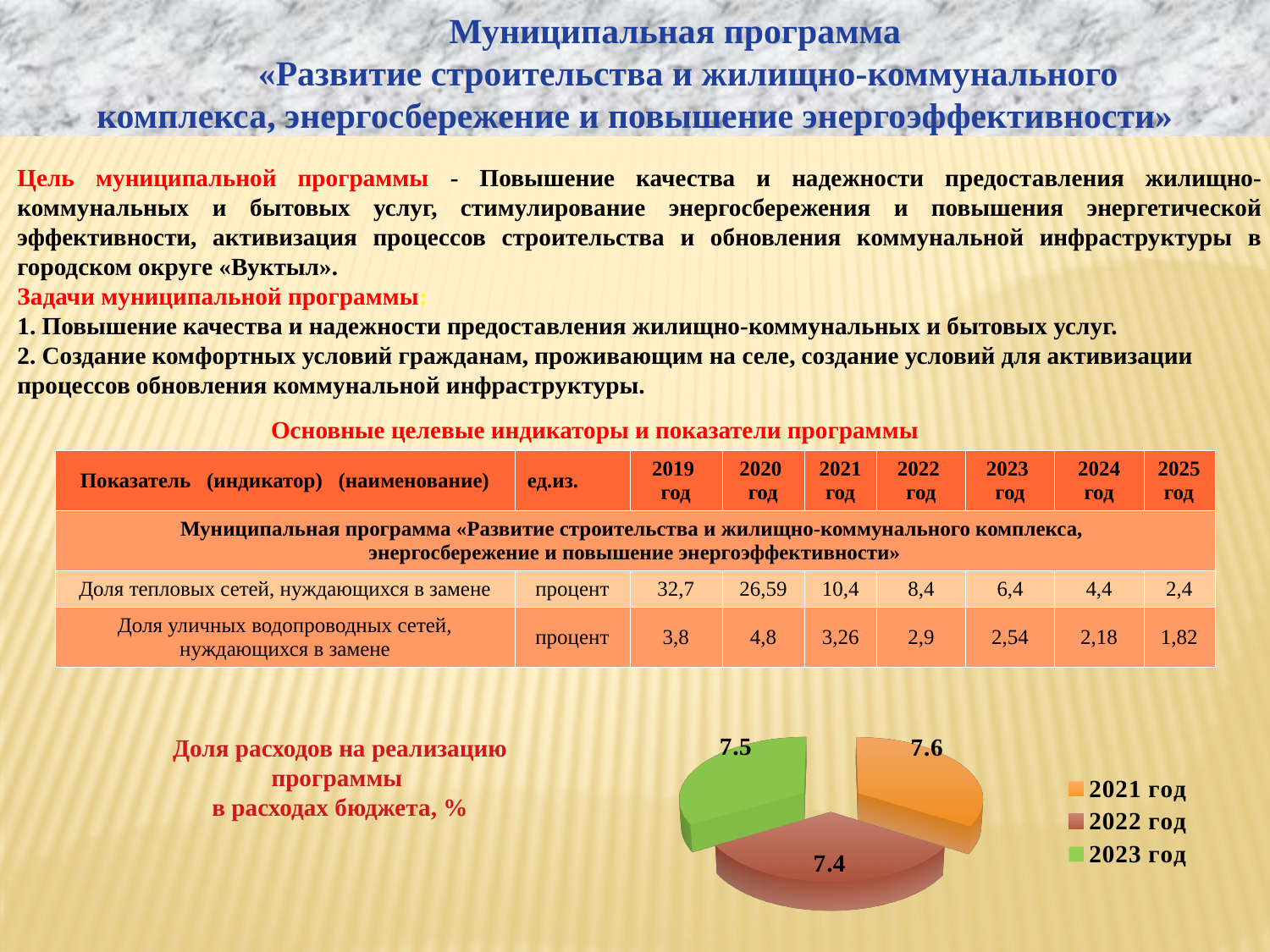
Which year has the highest value in the pie chart? 2021 год What is the value for 2023 год in the pie chart? 7.5 What is the value for 2022 год in the pie chart? 7.4 What is the difference between the values for 2021 год and 2022 год in the pie chart? 0.2 What is the title of the pie chart? Доля расходов на реализацию программы в расходах бюджета, % How many entries does the legend of the pie chart list? 3 What is the value for 2021 год in the pie chart? 7.6 Which year has the lowest value in the pie chart? 2022 год What kind of chart is shown at the bottom of the slide? pie chart Which is larger in the pie chart, the value for 2023 год or the value for 2022 год? 2023 год How many slices does the pie chart have? 3 What colour is the slice for 2023 год in the pie chart? green